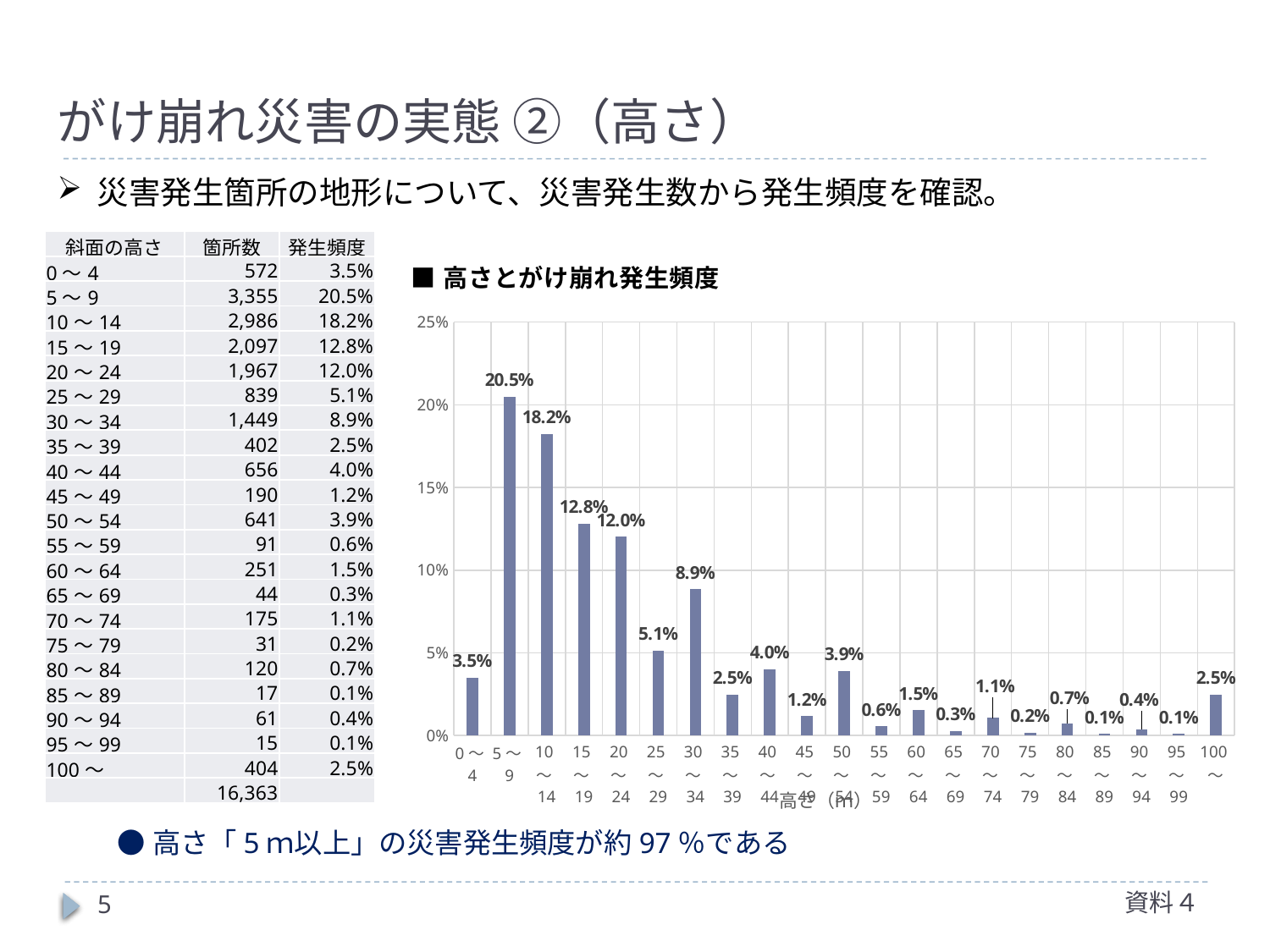
What is the 発生頻度 value for the 5〜9 category in the chart? 20.5% What is the title of the chart? 高さとがけ崩れ発生頻度 What is the value shown for the 30〜34 category? 8.9% What kind of chart is shown on the slide? bar chart Which category has the highest value in the chart? 5〜9 Do the values rise or fall from the 5〜9 category to the 25〜29 category? fall How many categories are plotted on the x axis of the chart? 21 What is the value shown for the 100〜 category? 2.5% Is the value for 10〜14 greater or less than 15%? greater Which is larger, the value for 25〜29 or the value for 30〜34? 30〜34 What is the difference between the values for 15〜19 and 20〜24? 0.8% What is the difference between the values for 5〜9 and 10〜14? 2.3%